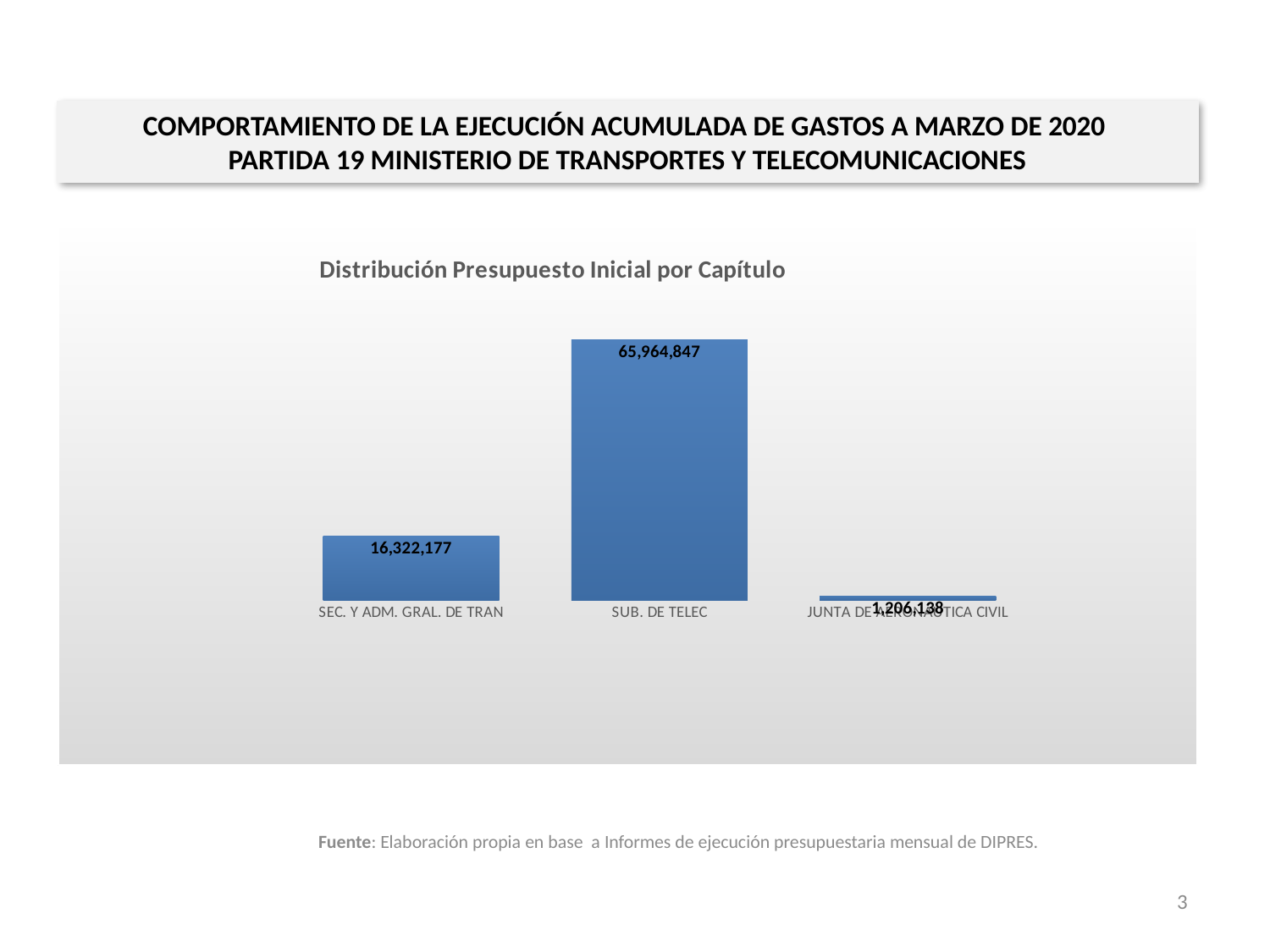
What is the title of the chart? Distribución Presupuesto Inicial por Capítulo Which category has the lowest value in the chart? JUNTA DE AERONÁUTICA CIVIL What is the value for SUB. DE TELEC in the chart? 65,964,847 What is the difference between the values for SEC. Y ADM. GRAL. DE TRAN and JUNTA DE AERONÁUTICA CIVIL? 15,116,039 Which category has the highest value in the chart? SUB. DE TELEC What is the value for SEC. Y ADM. GRAL. DE TRAN in the chart? 16,322,177 What colour are the bars in the chart? Blue What kind of chart is shown on the slide? Bar chart Which is larger, the value for SEC. Y ADM. GRAL. DE TRAN or the value for JUNTA DE AERONÁUTICA CIVIL? SEC. Y ADM. GRAL. DE TRAN What is the difference between the values for SUB. DE TELEC and SEC. Y ADM. GRAL. DE TRAN? 49,642,670 How many categories are shown in the chart? 3 What is the value for JUNTA DE AERONÁUTICA CIVIL in the chart? 1,206,138